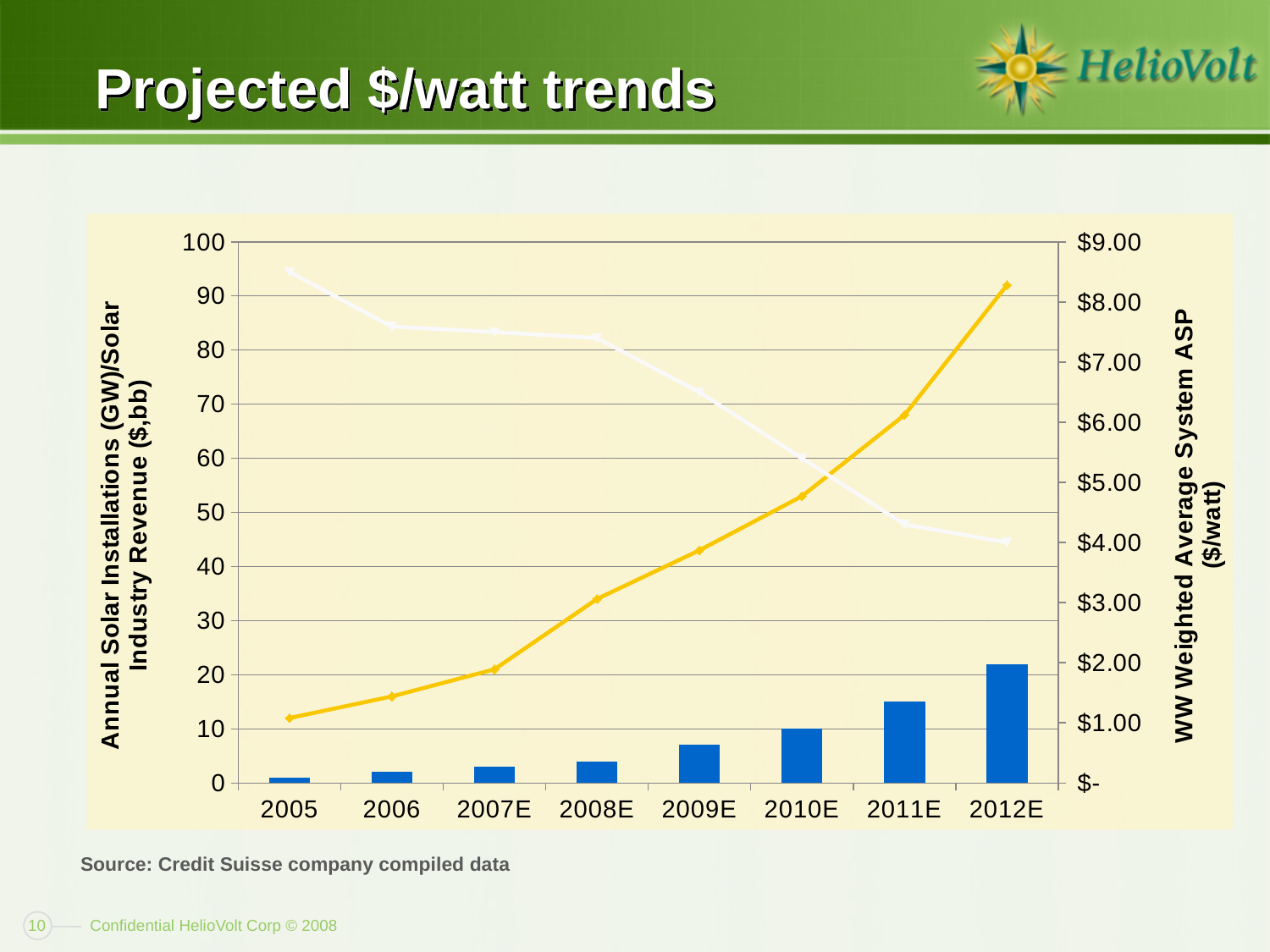
Which year has the tallest blue bar? 2012E Do the blue bars rise or fall from 2005 to 2012E? Rise What is the title of the right-hand vertical axis? WW Weighted Average System ASP ($/watt) Is the blue bar for 2011E greater or less than 10 on the left axis? greater Which blue bar is taller, 2010E or 2011E? 2011E What kind of chart is shown on the slide? A combination bar and line chart Does the yellow line rise or fall from 2005 to 2012E? Rise Is the white line value for 2012E greater or less than $5.00 on the right axis? less How many years are shown along the x axis of the chart? 8 Which year has the shortest blue bar? 2005 Is the blue bar for 2012E greater or less than 30 on the left axis? less Does the white line rise or fall from 2005 to 2012E? Fall